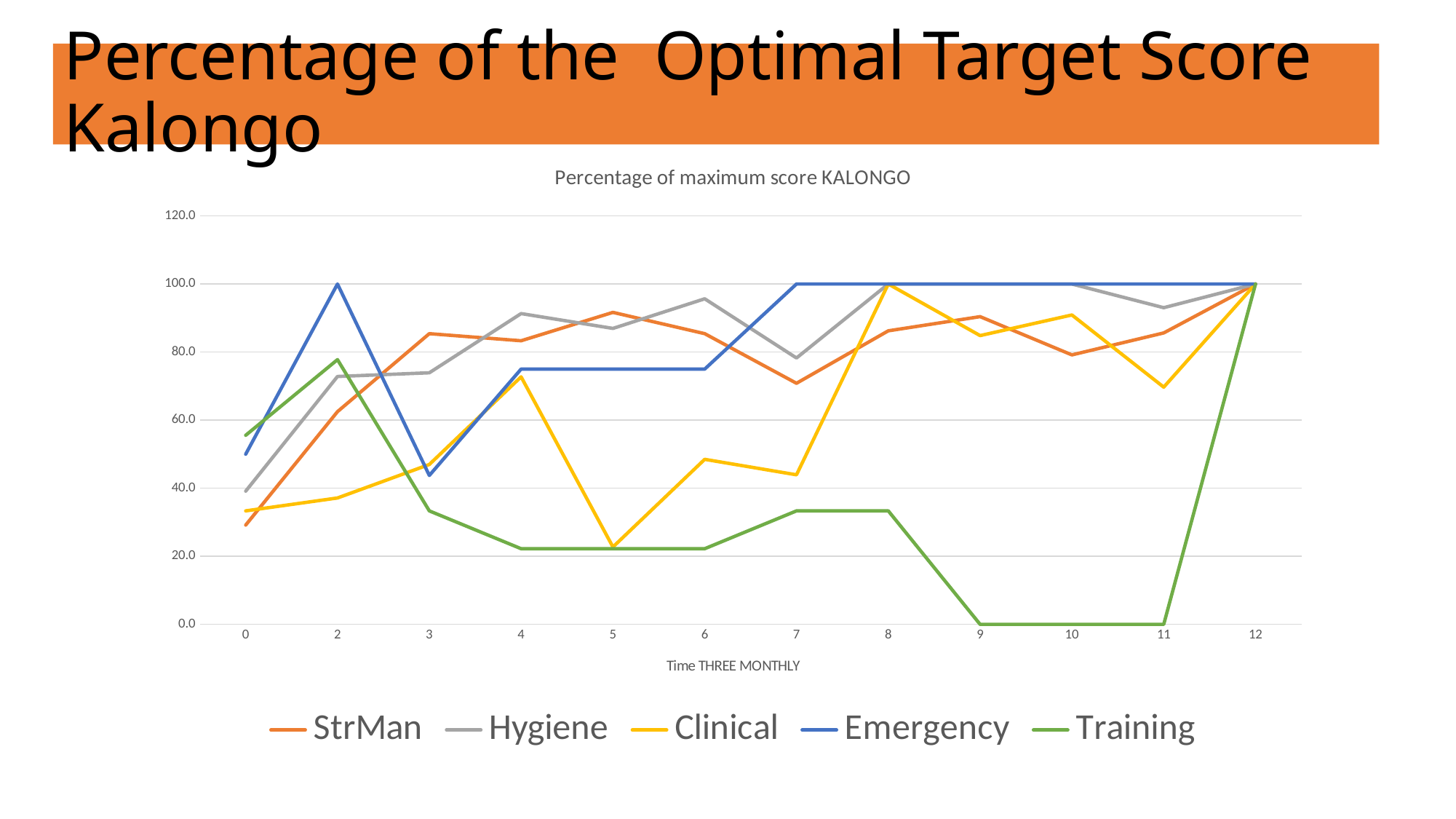
What is the title of the x axis? Time THREE MONTHLY What kind of chart is shown on the slide? line chart What is the value for Training at time 9? 0.0 How many series does the legend list? 5 Which series has the highest value at time 2? Emergency What is the value for Emergency at time 2? 100.0 How many time points are plotted along the x axis? 12 What is the value for Clinical at time 12? 100.0 Which series has the lowest value at time 10? Training Is the value for Hygiene at time 6 greater or less than 80? greater At time 7, which is larger, the value for Emergency or the value for Clinical? Emergency Is the value for Clinical at time 5 greater or less than 40? less